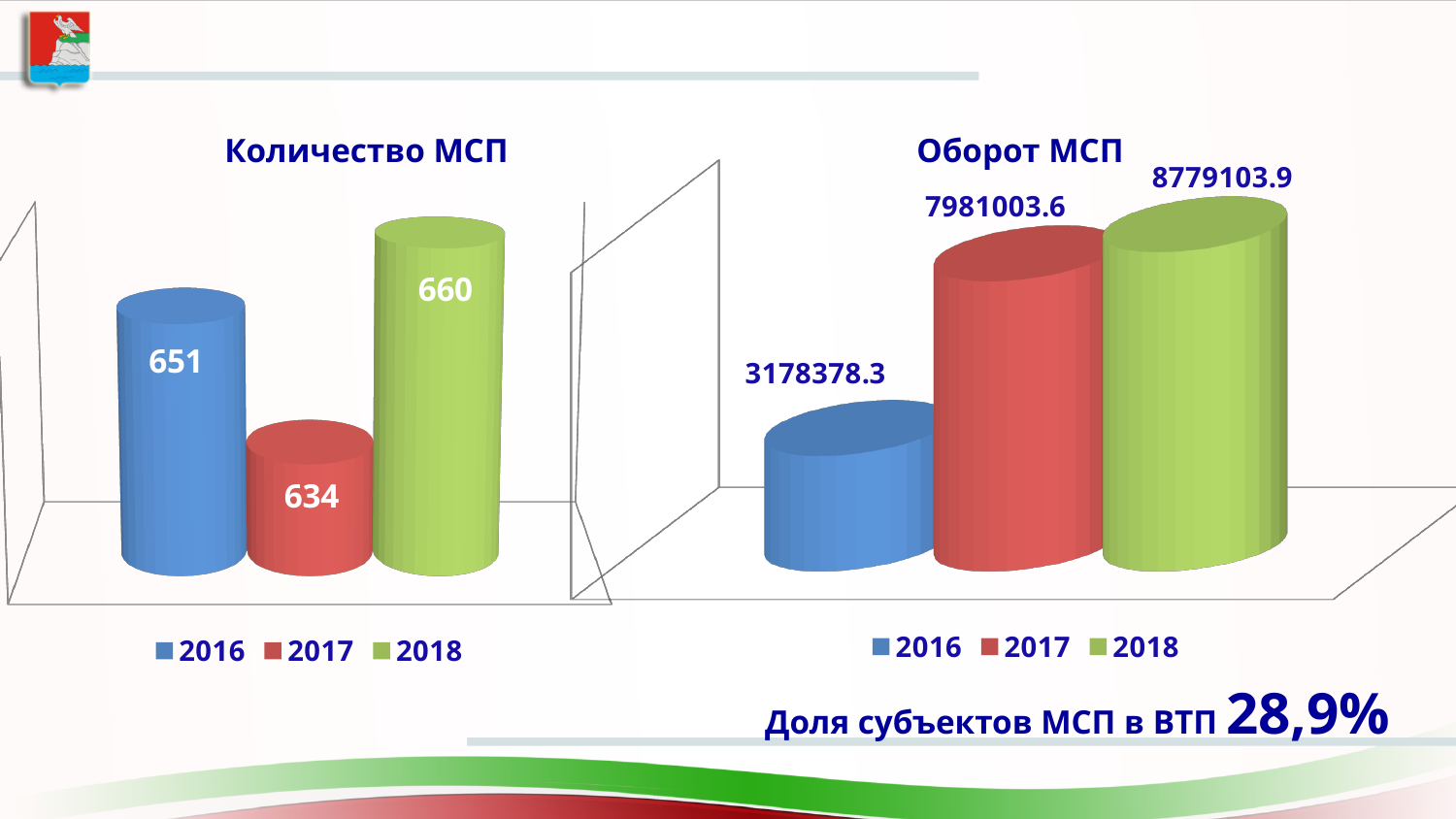
In the 'Количество МСП' chart, which year has the lowest value? 2017 In the 'Оборот МСП' chart, which year has the highest value? 2018 How many entries does the legend of the 'Оборот МСП' chart list? 3 In the 'Количество МСП' chart, what is the value for 2017? 634 In the 'Количество МСП' chart, what is the difference between the 2018 and 2017 values? 26 In the 'Оборот МСП' chart, what is the value for 2016? 3178378.3 In the 'Количество МСП' chart, what is the value for 2018? 660 In the 'Количество МСП' chart, which year has the highest value? 2018 In the 'Оборот МСП' chart, what is the difference between the 2018 and 2017 values? 798100.3 What kind of chart is the 'Количество МСП' chart? bar chart In the 'Оборот МСП' chart, do the values rise or fall from 2016 to 2018? rise In the 'Оборот МСП' chart, what is the value for 2018? 8779103.9